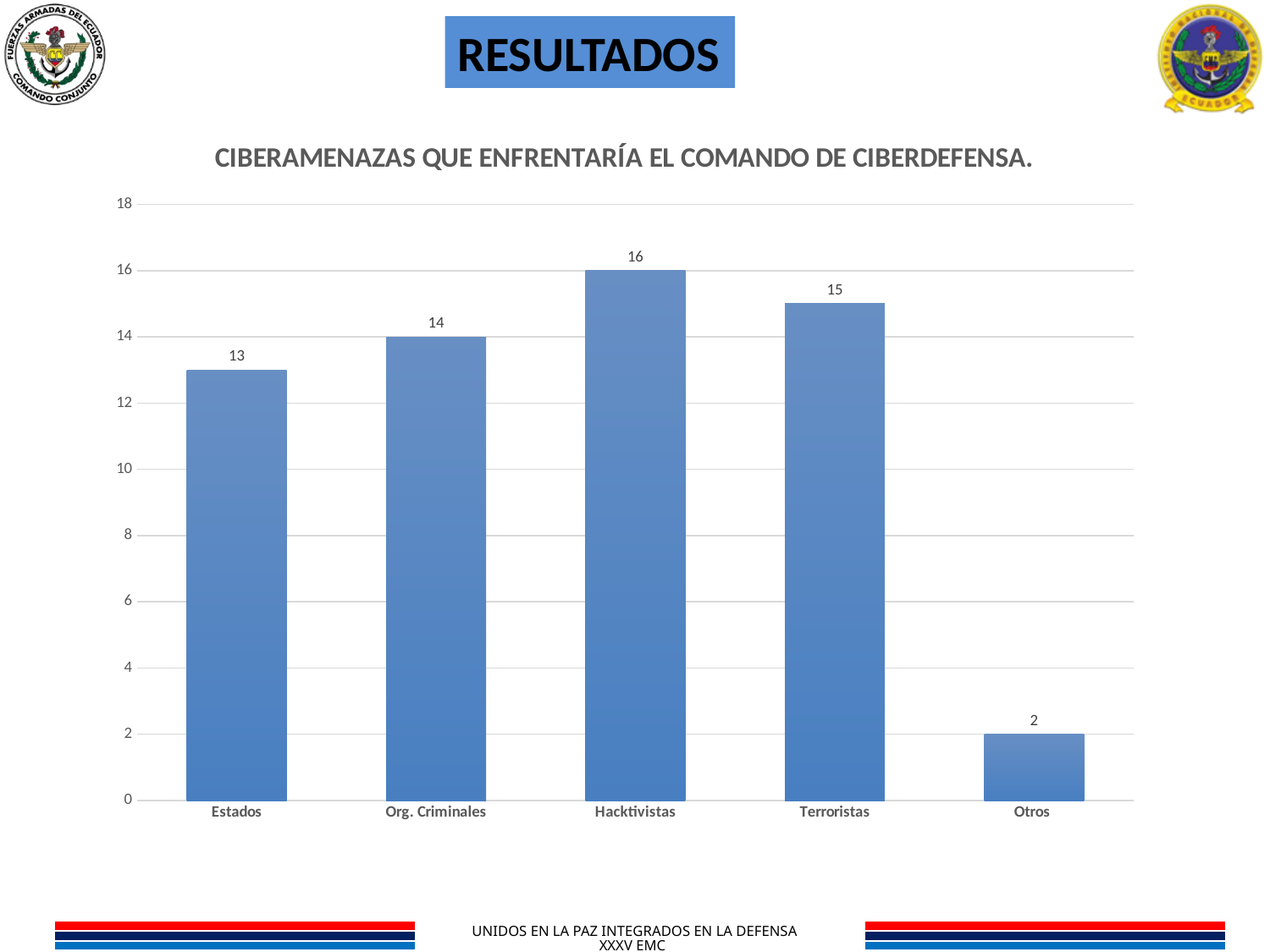
How many categories are shown on the x axis? 5 Which category has the lowest value? Otros What is the value for Hacktivistas? 16 What is the title of the chart? CIBERAMENAZAS QUE ENFRENTARÍA EL COMANDO DE CIBERDEFENSA. Which is larger, the value for Terroristas or the value for Org. Criminales? Terroristas What is the value for Otros? 2 What is the value for Estados? 13 What is the difference between the values for Hacktivistas and Estados? 3 Is the value for Terroristas greater or less than 10? greater What is the difference between the values for Org. Criminales and Otros? 12 What kind of chart is shown on the slide? Bar chart Which category has the highest value? Hacktivistas